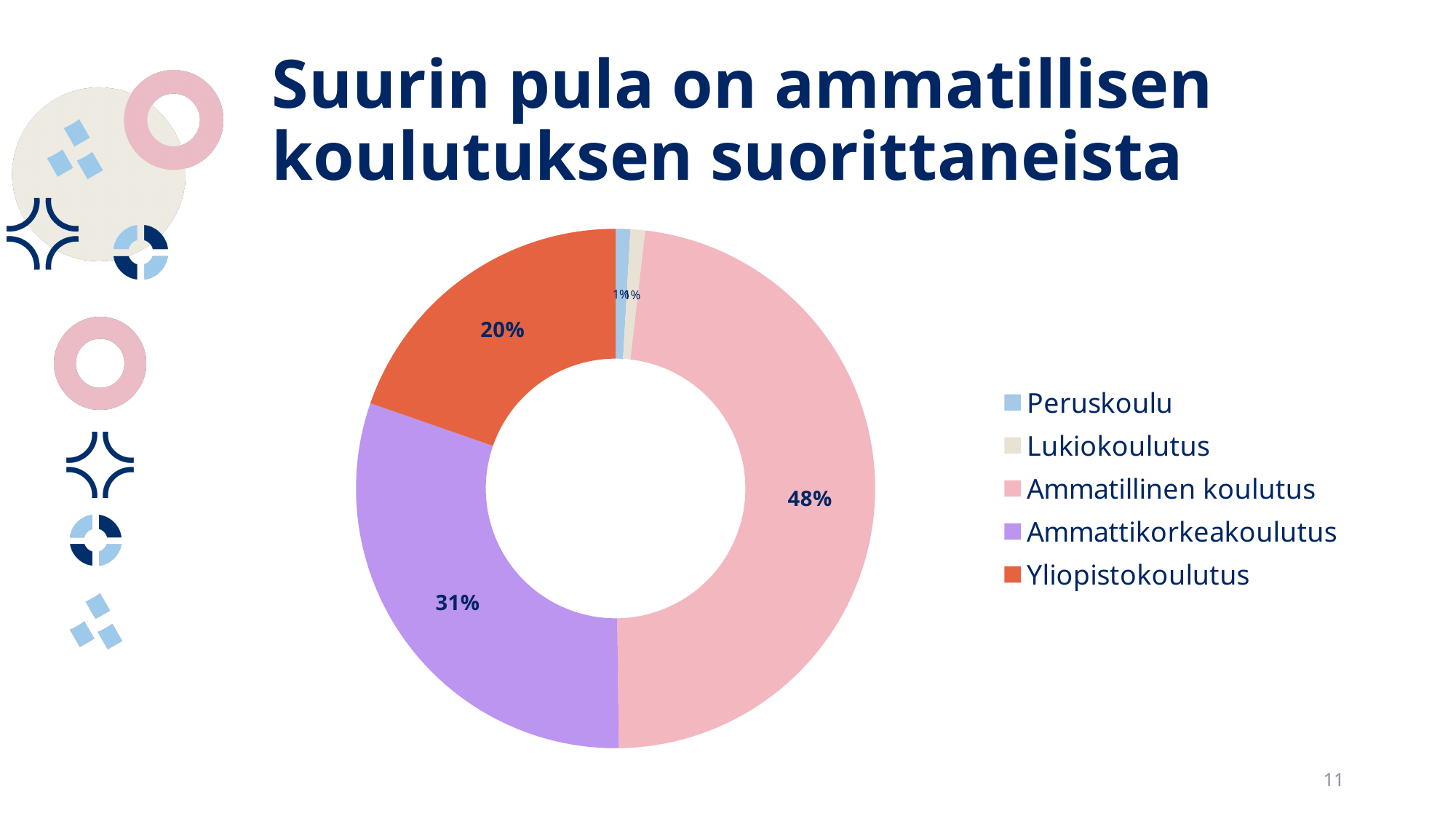
What colour is the Yliopistokoulutus slice? Orange-red How many categories does the legend list? 5 What is the title of the slide? Suurin pula on ammatillisen koulutuksen suorittaneista Which category has the largest share of the chart? Ammatillinen koulutus Is the share for Ammatillinen koulutus greater or less than 50%? less Which is larger, the share for Yliopistokoulutus or the share for Ammattikorkeakoulutus? Ammattikorkeakoulutus What is the difference in percentage points between Ammattikorkeakoulutus and Yliopistokoulutus? 11 percentage points What is the value shown for Ammattikorkeakoulutus? 31% What is the difference in percentage points between Ammatillinen koulutus and Ammattikorkeakoulutus? 17 percentage points What kind of chart is shown on the slide? Doughnut (pie) chart What is the value shown for Yliopistokoulutus? 20% What share of the chart does Ammatillinen koulutus have? 48%